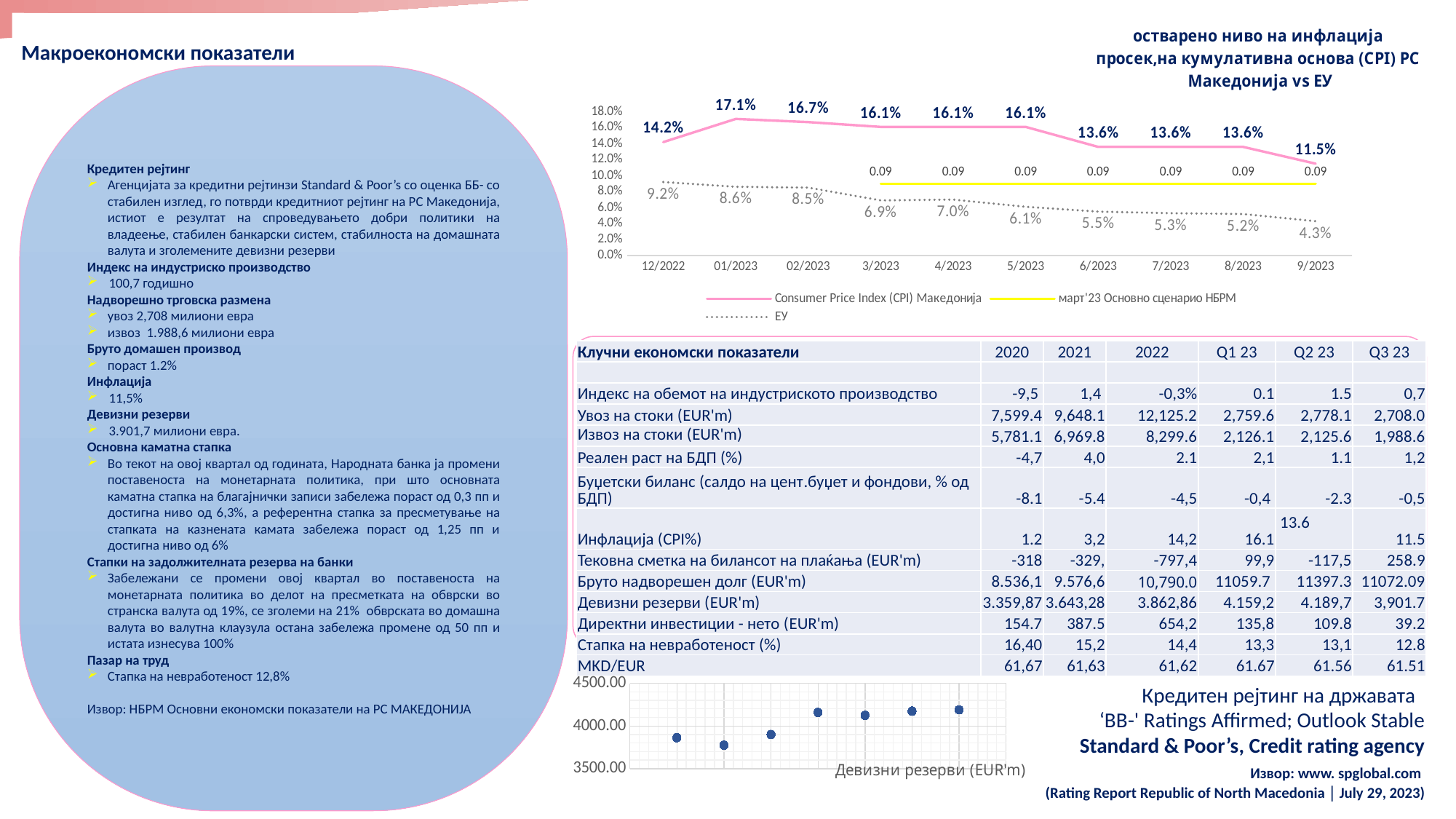
In the inflation line chart, what is the difference between the CPI Macedonia value and the EU value in 12/2022? 5.0% In the Девизни резерви (EUR'm) chart at the bottom of the slide, is the value of the last point greater or less than 4000? greater In the inflation line chart, what is the CPI Macedonia value in 9/2023? 11.5% In the inflation line chart, what is the Consumer Price Index (CPI) value for Macedonia in 01/2023? 17.1% In the inflation line chart, in which month does the CPI Macedonia series reach its highest value? 01/2023 In the inflation line chart, how many months are shown on the x axis? 10 In the inflation line chart, in which month is the EU series at its lowest value? 9/2023 In the inflation line chart, which is larger in 6/2023: the CPI Macedonia value or the EU value? CPI Macedonia In the inflation line chart, does the EU series rise or fall from 12/2022 to 9/2023? fall In the inflation line chart, what is the EU value in 9/2023? 4.3% What kind of chart is the chart at the bottom of the slide labelled Девизни резерви (EUR'm)? scatter chart In the inflation line chart, how many series does the legend list? 3